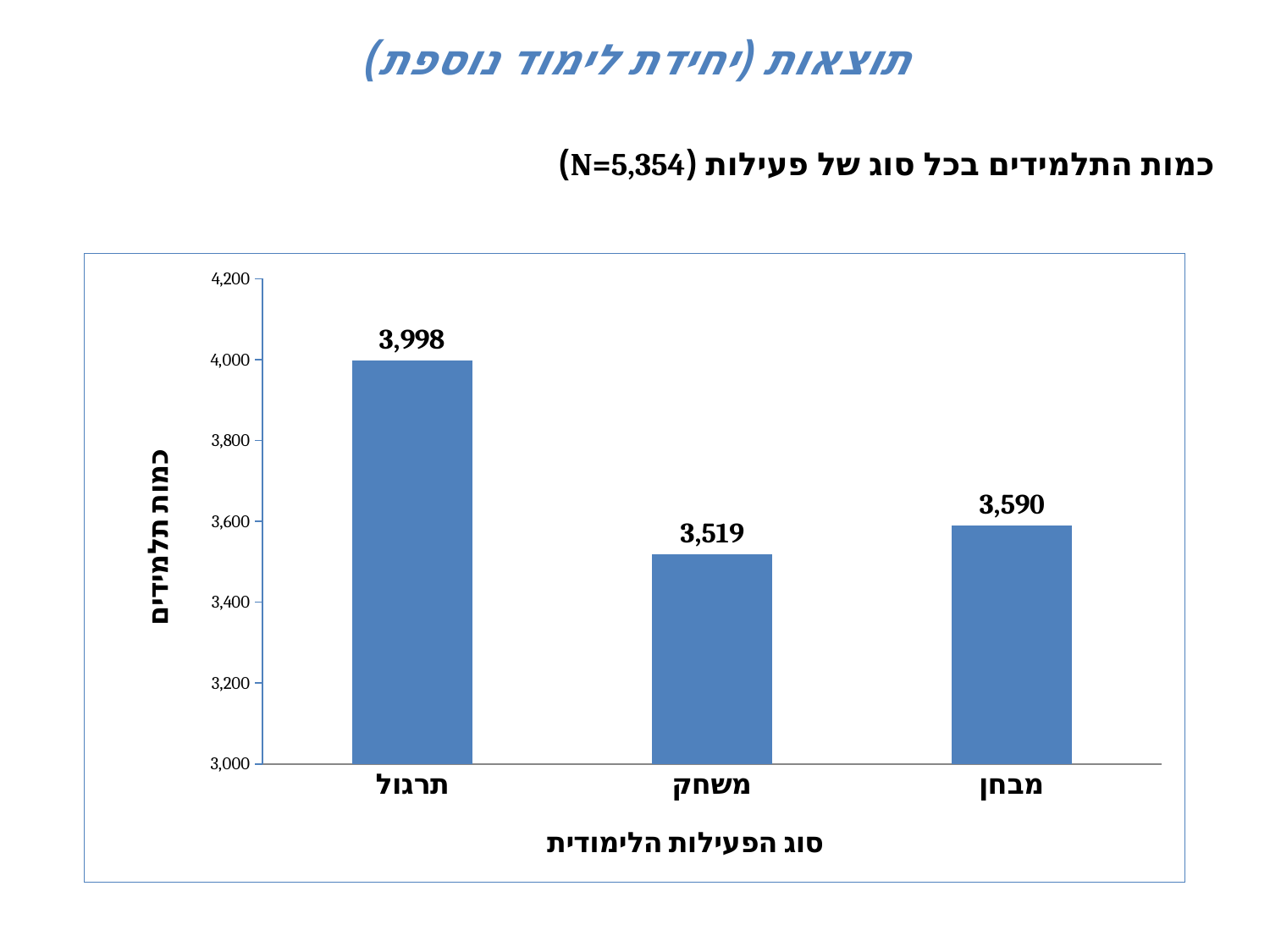
What is the difference between the values for מבחן and משחק? 71 Which category has the lowest value? משחק How many categories are shown on the x axis? 3 What kind of chart is shown on the slide? bar chart What is the value for תרגול? 3,998 What is the value for מבחן? 3,590 What is the label of the y axis? כמות תלמידים What is the difference between the values for תרגול and משחק? 479 Which category has the highest value? תרגול What is the value for משחק? 3,519 Which is larger, the value for מבחן or the value for משחק? מבחן Is the value for תרגול greater or less than 3,800? greater